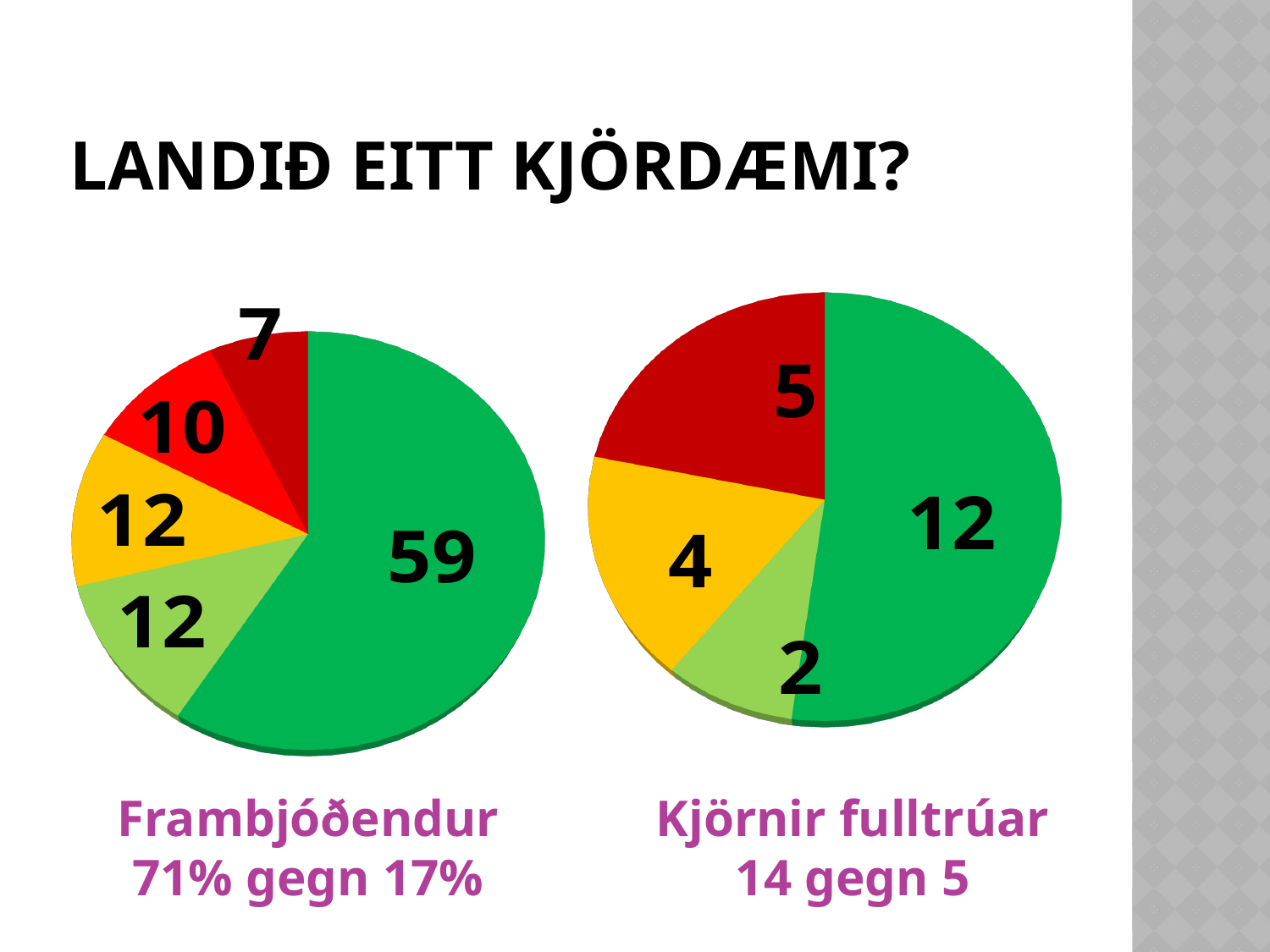
In the right pie chart (Kjörnir fulltrúar), what is the value of the smallest slice? 2 How many slices does the left pie chart (Frambjóðendur) have? 5 What is the total of all slices in the right pie chart (Kjörnir fulltrúar)? 23 In the left pie chart (Frambjóðendur), what is the difference between the dark green slice (59) and the yellow slice (12)? 47 In the right pie chart (Kjörnir fulltrúar), what is the value of the yellow slice? 4 In the left pie chart (Frambjóðendur), what is the value of the largest slice? 59 How many slices does the right pie chart (Kjörnir fulltrúar) have? 4 In the left pie chart (Frambjóðendur), what is the value of the large dark green slice? 59 What is the label shown under the left pie chart? Frambjóðendur 71% gegn 17% What kind of chart is the left chart (Frambjóðendur)? Pie chart In the right pie chart (Kjörnir fulltrúar), how much larger is the dark green slice than the dark red slice? 7 In the right pie chart (Kjörnir fulltrúar), which is larger: the yellow slice or the dark red slice? The dark red slice